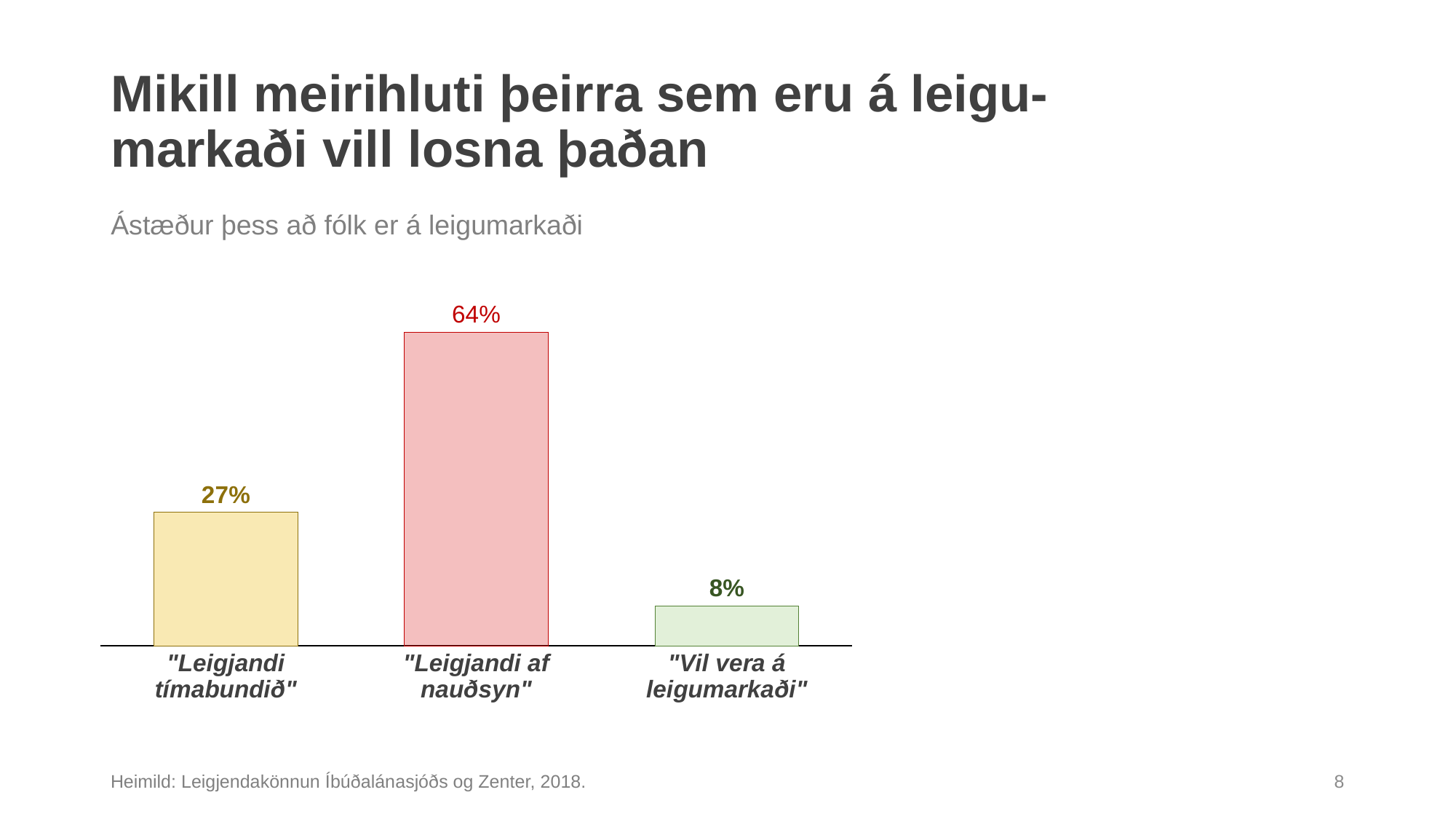
What is the difference between the values for "Leigjandi af nauðsyn" and "Leigjandi tímabundið"? 37% What kind of chart is shown on the slide? Bar chart What is the value for "Leigjandi af nauðsyn"? 64% What is the subtitle describing the chart? Ástæður þess að fólk er á leigumarkaði Which category has the highest value? "Leigjandi af nauðsyn" Which is larger, the value for "Leigjandi tímabundið" or the value for "Vil vera á leigumarkaði"? "Leigjandi tímabundið" Which category has the lowest value? "Vil vera á leigumarkaði" What colour is the bar for "Leigjandi af nauðsyn"? Red (pink) How many categories are shown in the chart? 3 What is the value for "Vil vera á leigumarkaði"? 8% What is the difference between the values for "Leigjandi tímabundið" and "Vil vera á leigumarkaði"? 19% What is the value for "Leigjandi tímabundið"? 27%